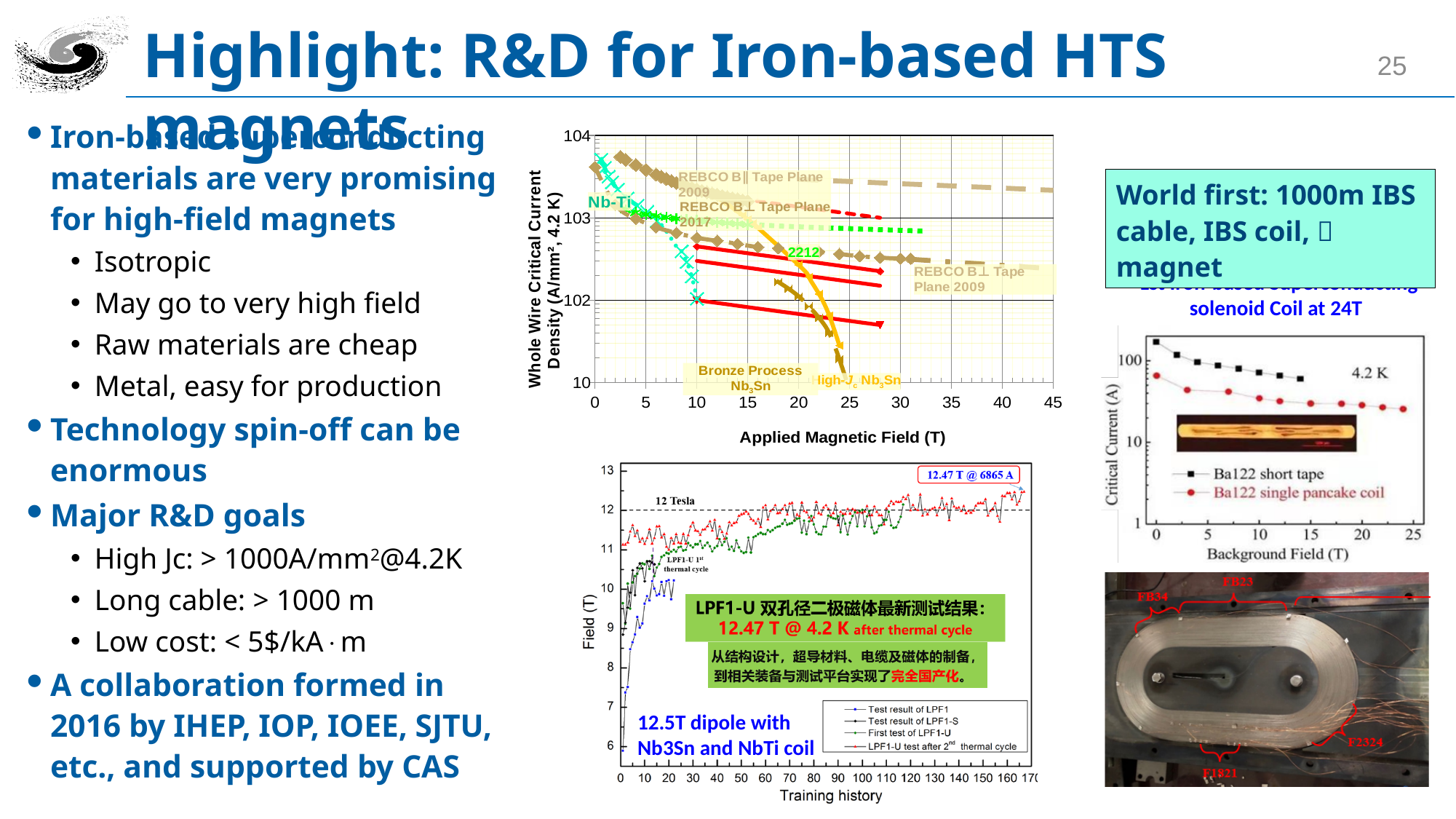
In the right-hand chart of critical current versus background field, how many series does the legend list? 2 In the right-hand chart of critical current versus background field, what are the two legend entries? Ba122 short tape; Ba122 single pancake coil In the bottom-center chart of field versus training history, how many series does the legend list? 4 In the top-center chart of critical current density versus applied magnetic field, what is the largest value shown on the x axis? 45 In the bottom-center chart of field versus training history, what peak field and current are annotated in the top-right corner? 12.47 T @ 6865 A In the right-hand chart of critical current versus background field, does the critical current of the Ba122 short tape rise or fall as the background field increases? fall In the bottom-center chart of field versus training history, what kind of chart is it? line chart In the right-hand chart of critical current versus background field, is the critical current of the Ba122 short tape at 0 T greater or less than 100? greater In the right-hand chart of critical current versus background field, is the critical current of the Ba122 single pancake coil at 20 T greater or less than 100? less In the bottom-center chart of field versus training history, what field value does the horizontal dashed reference line mark? 12 Tesla In the top-center chart of critical current density versus applied magnetic field, does the Nb-Ti curve rise or fall as the applied field increases? fall In the right-hand chart of critical current versus background field, which series has the higher critical current at 5 T: Ba122 short tape or Ba122 single pancake coil? Ba122 short tape